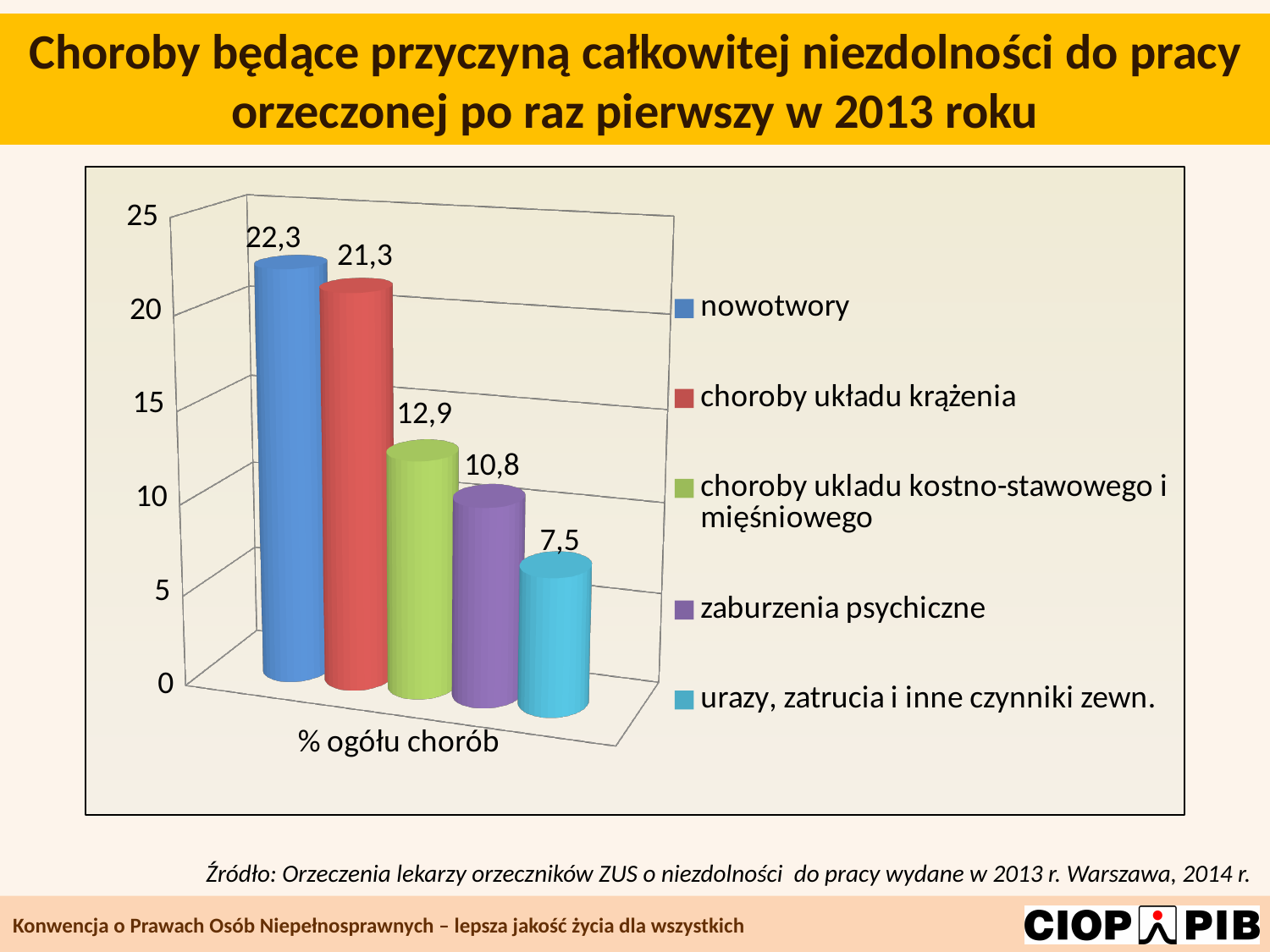
What is the label shown on the category axis of the chart? % ogółu chorób What is the value for urazy, zatrucia i inne czynniki zewn.? 7,5 What kind of chart is shown on the slide? bar chart How many series does the legend list? 5 What is the value for zaburzenia psychiczne? 10,8 What is the value for nowotwory? 22,3 What is the difference between the values for choroby ukladu kostno-stawowego i mięśniowego and urazy, zatrucia i inne czynniki zewn.? 5,4 Which series has the highest value? nowotwory Which is larger, the value for choroby ukladu kostno-stawowego i mięśniowego or the value for zaburzenia psychiczne? choroby ukladu kostno-stawowego i mięśniowego What is the value for choroby układu krążenia? 21,3 Which series has the lowest value? urazy, zatrucia i inne czynniki zewn. What is the difference between the values for nowotwory and choroby układu krążenia? 1,0